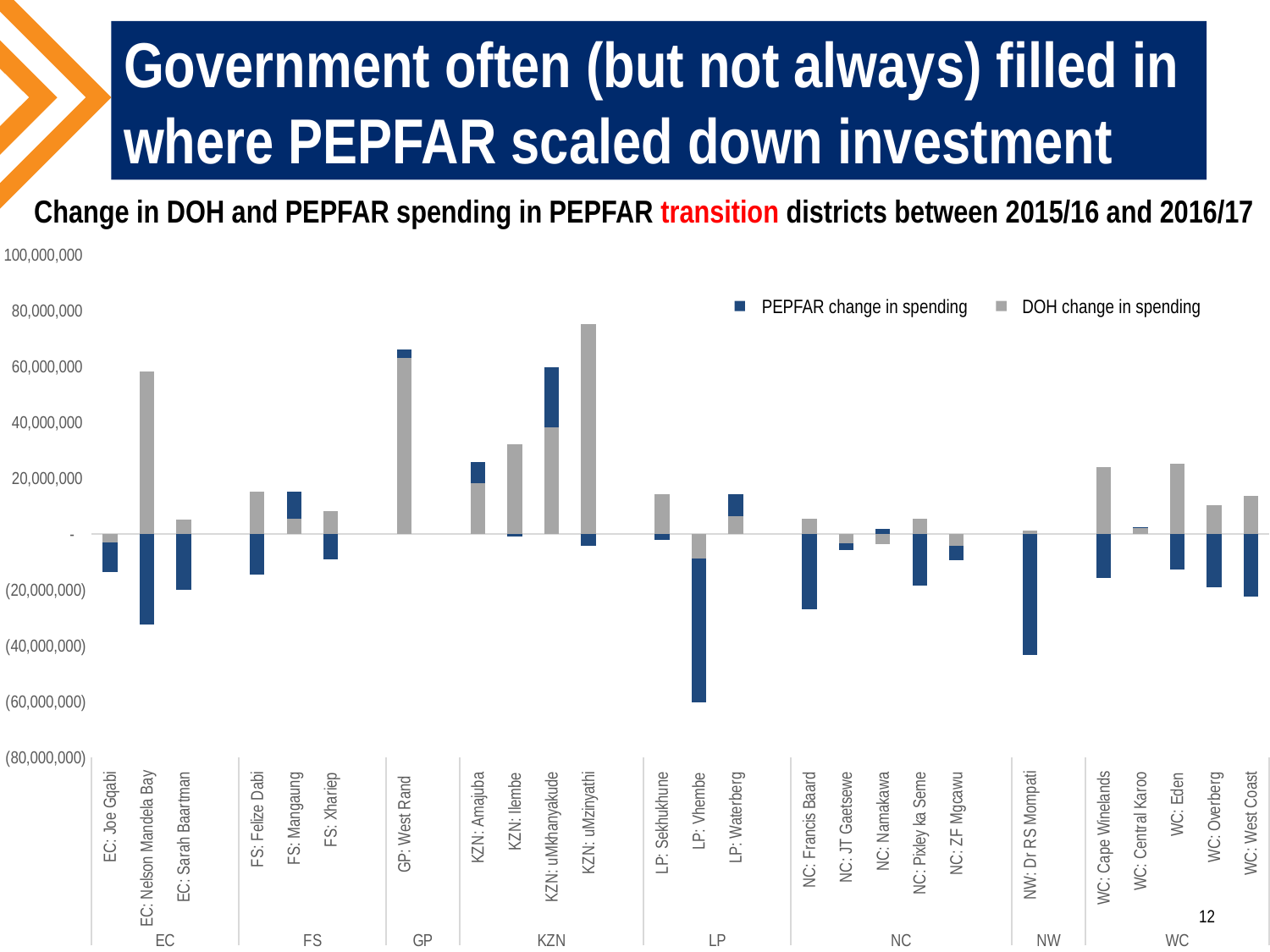
Is the DOH change in spending for GP: West Rand greater or less than 40,000,000? greater How many districts are plotted along the x axis of the chart? 25 Which series is shown in dark blue in the chart? PEPFAR change in spending How many series does the chart legend list? 2 How many province groups (EC, FS, GP, etc.) are shown along the x axis? 8 Which district has the larger DOH change in spending, EC: Nelson Mandela Bay or FS: Felize Dabi? EC: Nelson Mandela Bay Is the PEPFAR change in spending for LP: Vhembe greater or less than (40,000,000)? less Which district has the highest DOH change in spending? KZN: uMzinyathi Which district has the largest positive PEPFAR change in spending? KZN: uMkhanyakude Which district has the lowest (most negative) PEPFAR change in spending? LP: Vhembe What kind of chart is shown on the slide? Stacked bar chart Is the DOH change in spending for KZN: uMzinyathi greater or less than 60,000,000? greater